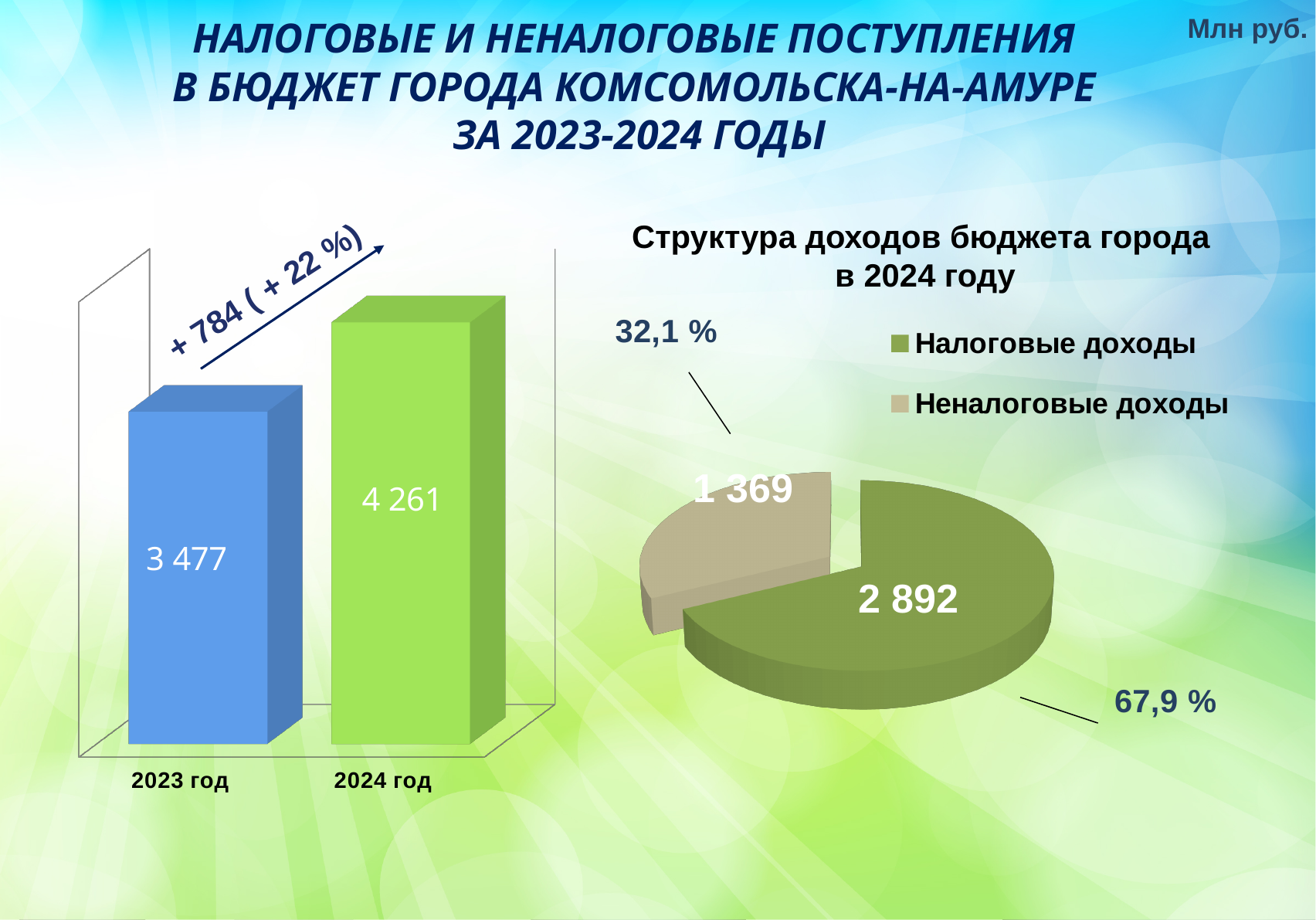
On the pie chart 'Структура доходов бюджета города в 2024 году', which slice is larger, Налоговые доходы or Неналоговые доходы? Налоговые доходы On the bar chart on the left, how many bars are shown? 2 On the pie chart 'Структура доходов бюджета города в 2024 году', what is the value for Налоговые доходы? 2 892 On the pie chart 'Структура доходов бюджета города в 2024 году', what is the value for Неналоговые доходы? 1 369 On the bar chart on the left, do the values rise or fall from 2023 год to 2024 год? rise On the bar chart on the left, what is the value for 2023 год? 3 477 On the bar chart on the left, which year has the higher value? 2024 год On the pie chart 'Структура доходов бюджета города в 2024 году', what share does Неналоговые доходы have? 32,1 % On the bar chart on the left, what is the difference between the 2024 год and 2023 год values? 784 On the bar chart on the left, what is the value for 2024 год? 4 261 What kind of chart is shown on the left of the slide? bar chart How many entries does the legend of the pie chart 'Структура доходов бюджета города в 2024 году' list? 2